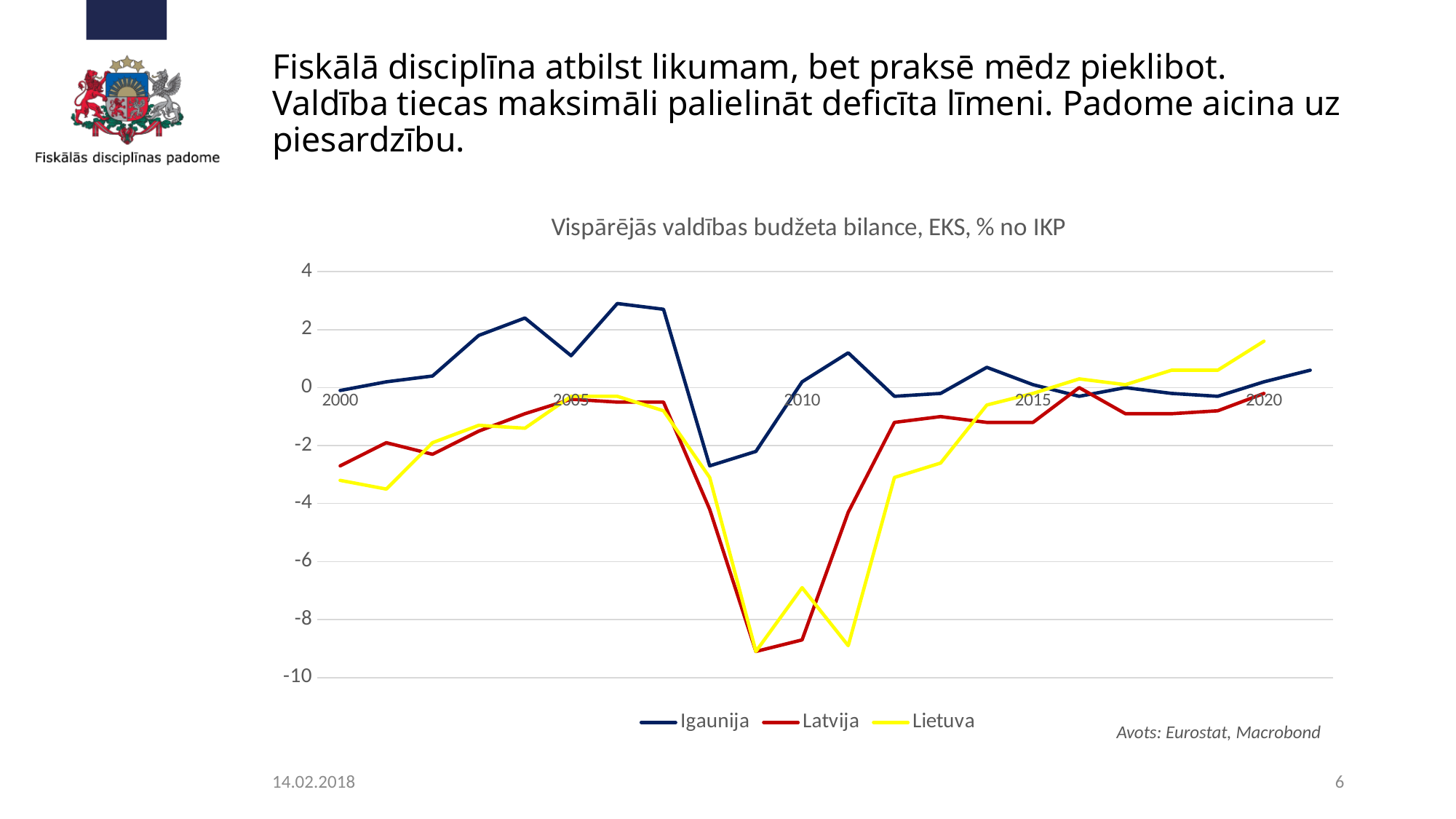
Is the value for Igaunija in 2005 greater or less than 0? greater Does the Lietuva line rise or fall between 2015 and 2020? rise What is the title of the chart? Vispārējās valdības budžeta bilance, EKS, % no IKP Is the value for Latvija in 2010 greater or less than -8? less Is the value for Lietuva in 2000 greater or less than -2? less Which series is drawn in yellow? Lietuva What kind of chart is shown on the slide? line chart How many series does the legend list? 3 Which series has the highest value in 2020? Lietuva In 2010, which is higher, Igaunija or Latvija? Igaunija